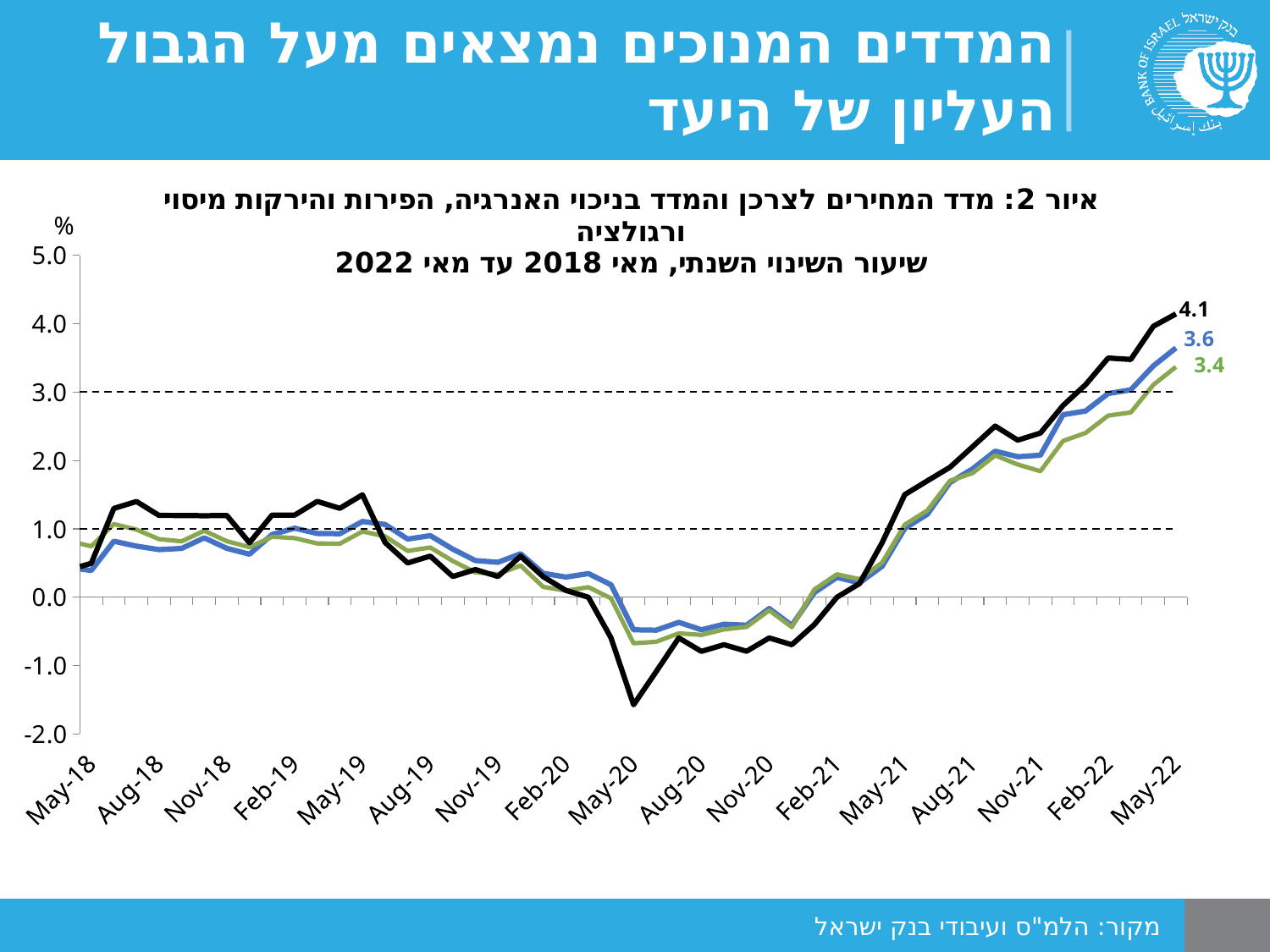
What is the difference between the May-22 values of the black line (4.1) and the blue line (3.6)? 0.5 Which line has the lowest labelled value at May-22? the green line How many lines are plotted on the chart? 3 Is the black line's value at Feb-22 greater or less than 3.0? greater Which line has the highest labelled value at May-22? the black line What is the final value (May-22) labelled on the green line? 3.4 What is the final value (May-22) labelled on the blue line? 3.6 Is the black line's value at May-20 greater or less than -1.0? less Do the lines rise or fall between May-21 and May-22? rise What is the final value (May-22) labelled on the black line? 4.1 What kind of chart is shown on the slide? line chart What is the difference between the May-22 values of the blue line (3.6) and the green line (3.4)? 0.2